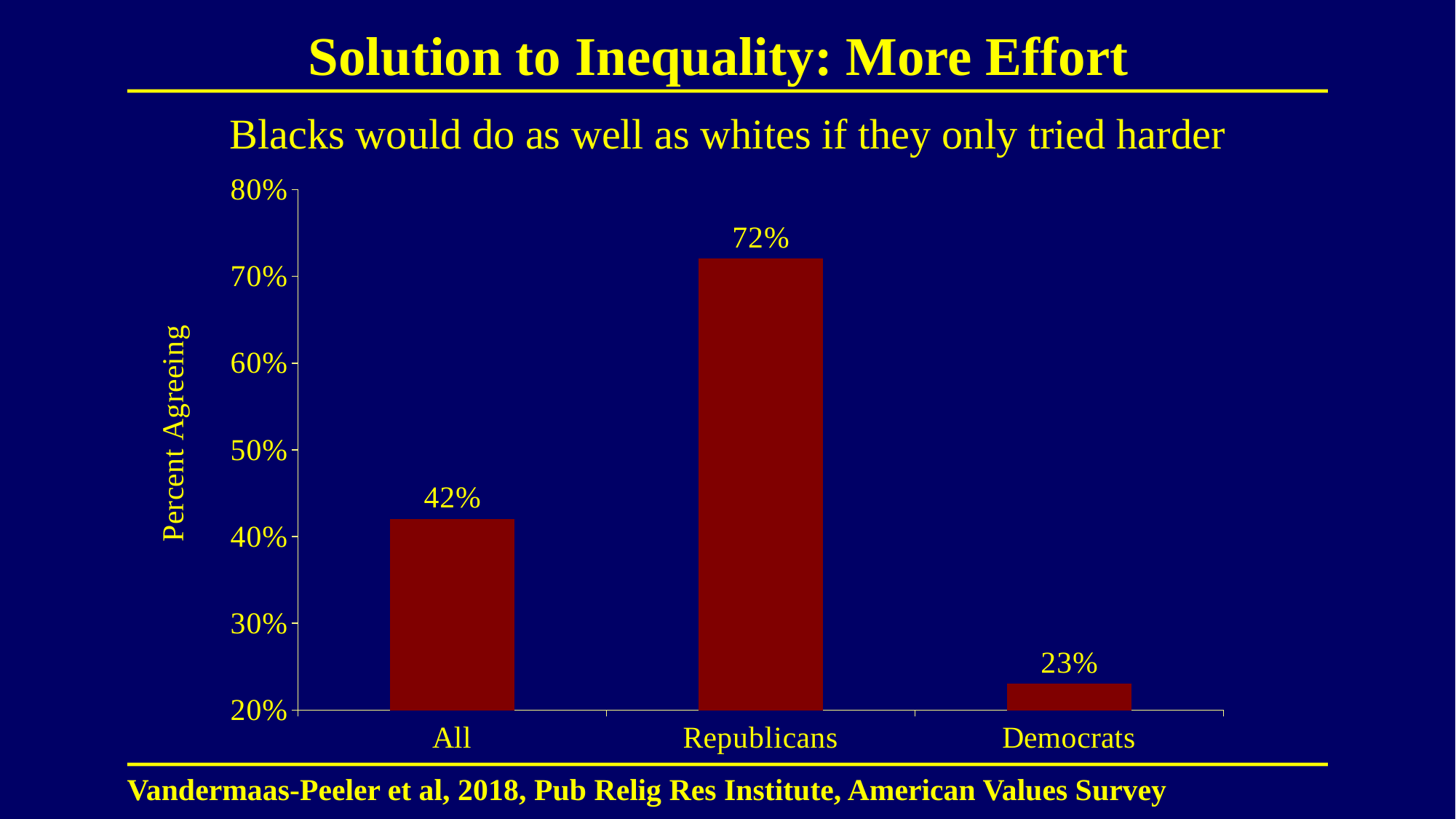
What is the difference in percent agreeing between Republicans and Democrats? 49% Which is larger, the value for All or the value for Democrats? All What kind of chart is shown on the slide? bar chart What is the label of the vertical axis? Percent Agreeing Is the value for Democrats greater or less than 30%? less What is the difference between the Republicans value and the All value? 30% Which group has the highest percent agreeing? Republicans What percentage of Democrats agree with the statement? 23% What percentage of Republicans agree that Blacks would do as well as whites if they only tried harder? 72% Which group has the lowest percent agreeing? Democrats What is the value shown for the All category? 42% How many categories are shown on the x axis? 3